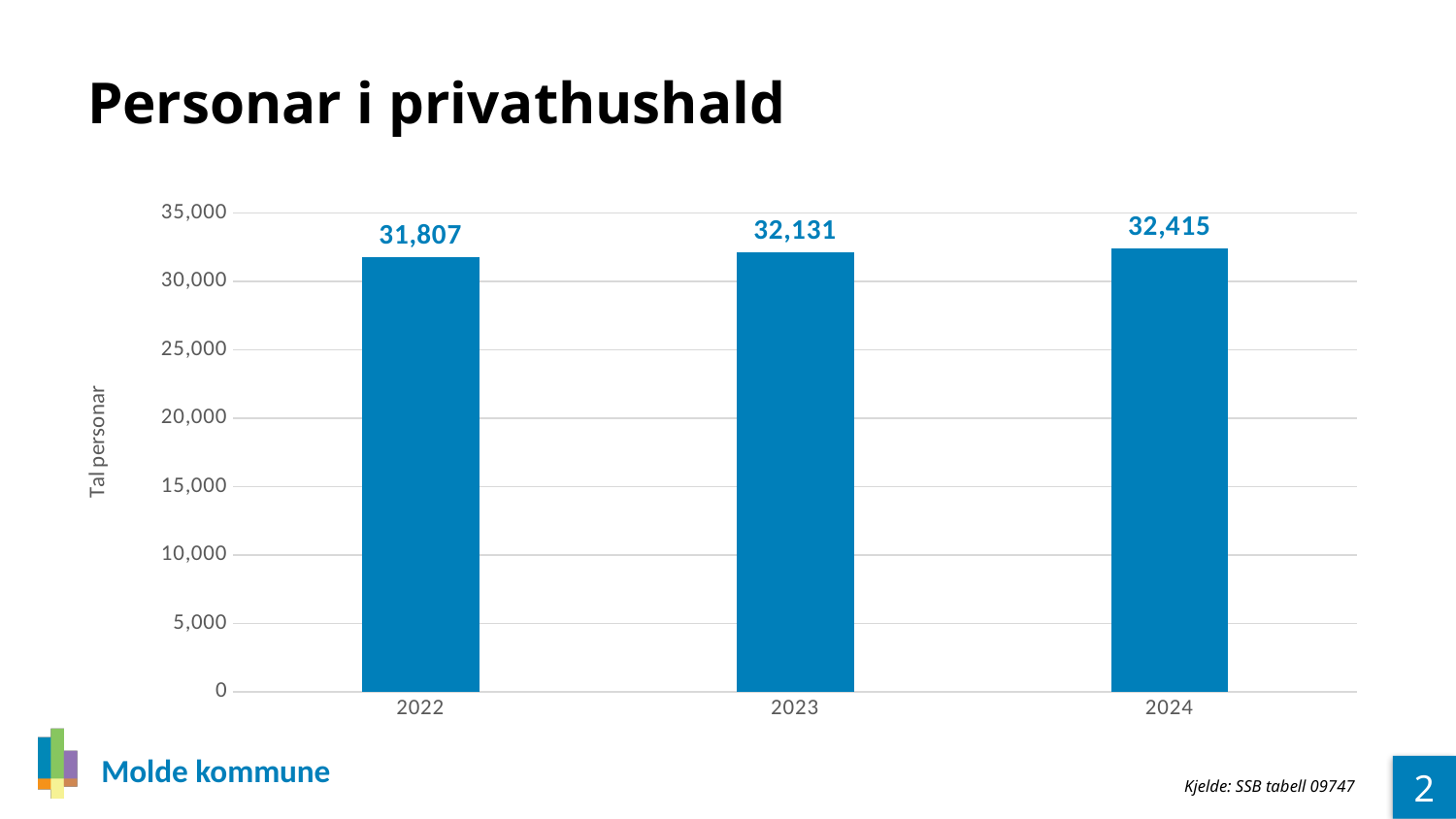
Which year has the lowest value? 2022 How many years are shown on the x axis? 3 What is the difference between the values for 2023 and 2022? 324 What is the difference between the values for 2024 and 2022? 608 Is the value for 2022 greater or less than 30,000? greater Which is larger, the value for 2023 or the value for 2024? 2024 What is the value for 2022? 31,807 What is the value for 2024? 32,415 What kind of chart is shown on the slide? bar chart Do the values rise or fall from 2022 to 2024? rise Which year has the highest value? 2024 What is the value for 2023? 32,131